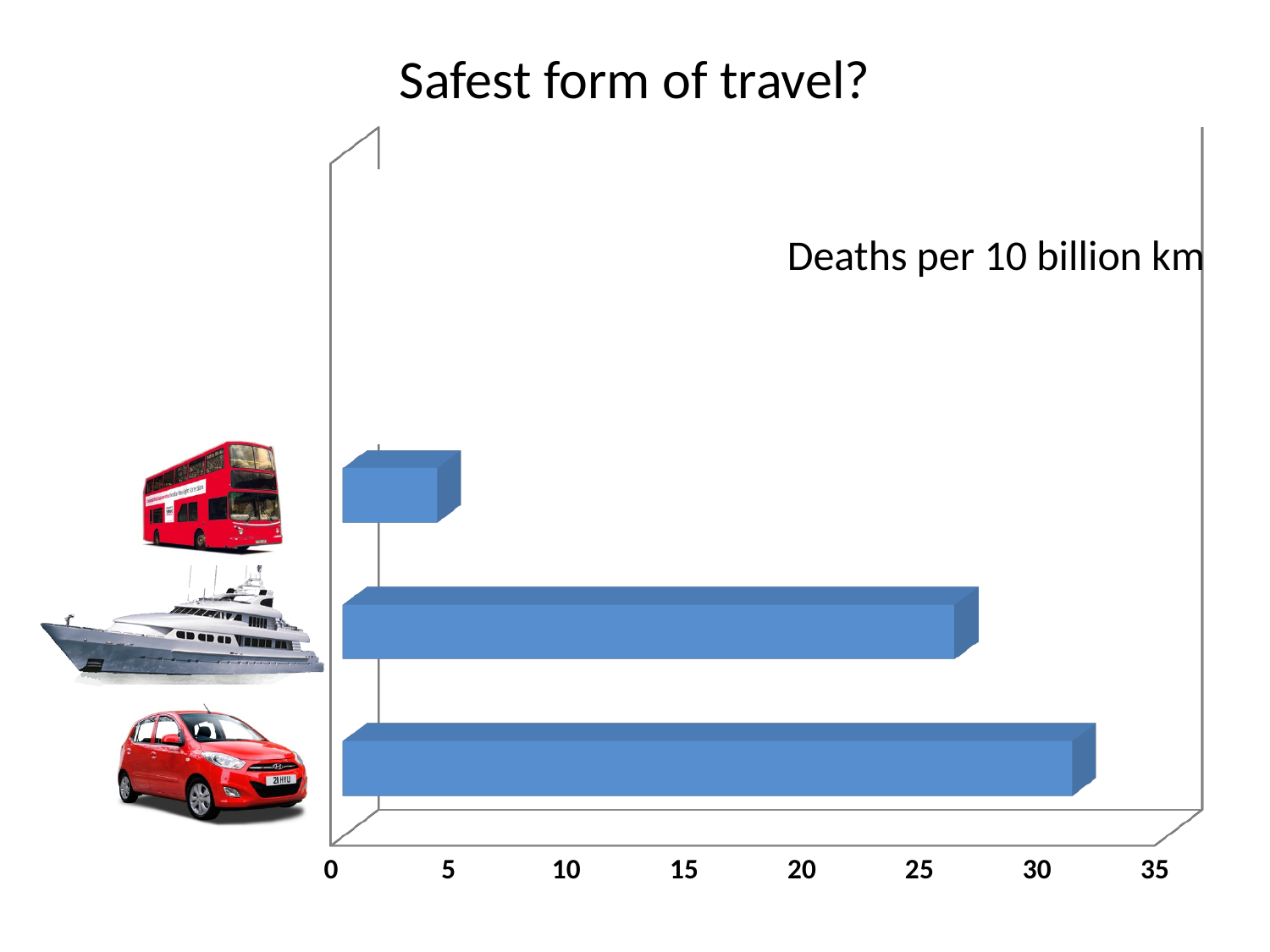
Is the value for the car greater or less than 30? greater How many bars are plotted in the chart? 3 What quantity does the chart measure, according to the label on the chart? Deaths per 10 billion km What kind of chart is shown on the slide? bar chart What is the title of the slide? Safest form of travel? Is the value for the bus greater or less than 10? less Is the value for the boat greater or less than 25? greater Which form of travel has the lowest number of deaths per 10 billion km in the chart? bus Which form of travel has the highest number of deaths per 10 billion km in the chart? car Which has the larger value in the chart, the bus or the boat? boat Which has the larger value in the chart, the boat or the car? car